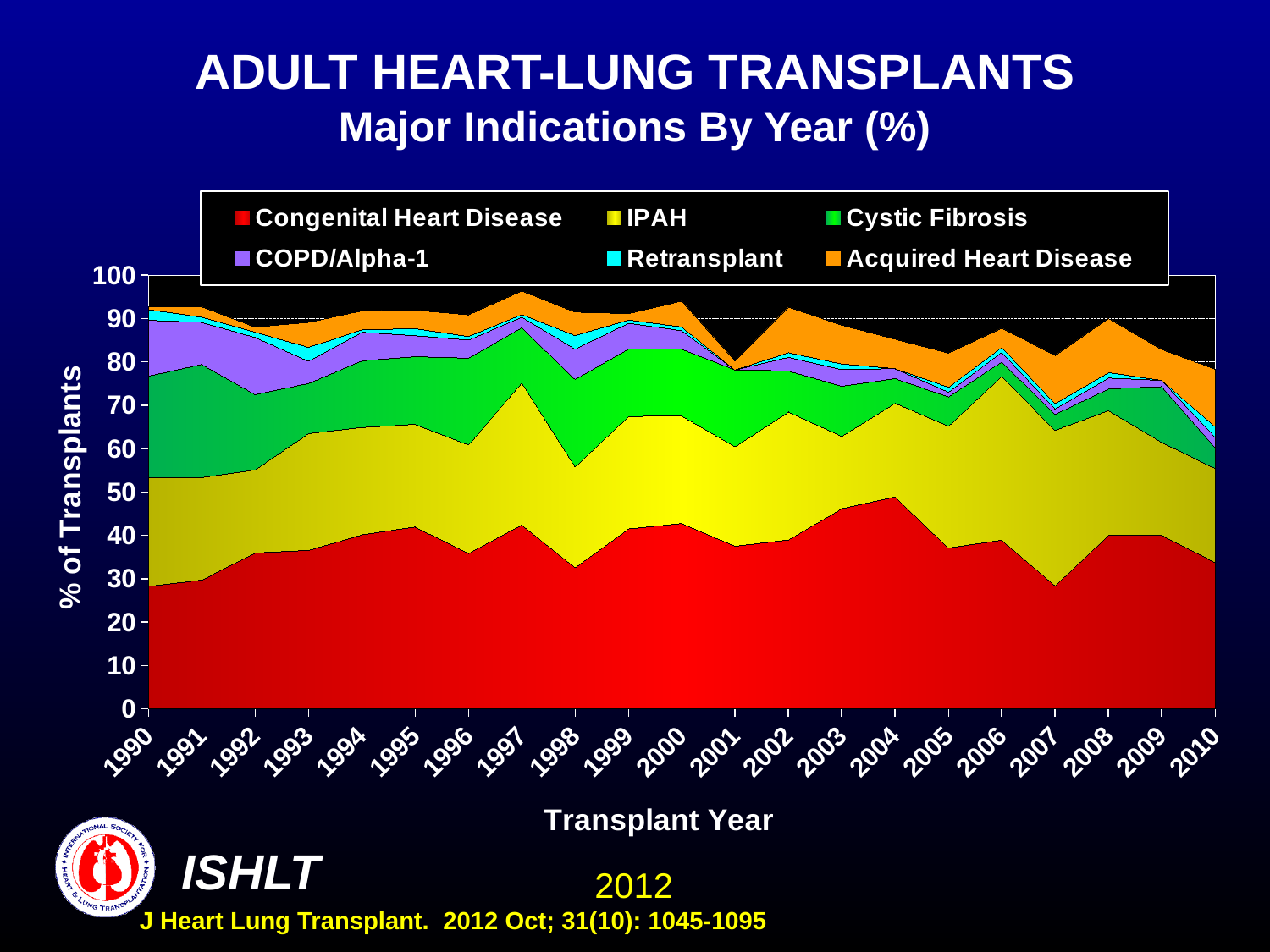
How many series does the legend list? 6 What colour represents Acquired Heart Disease in the legend? Orange Which indication has the largest share of transplants in 2010? Congenital Heart Disease Is the value for Congenital Heart Disease in 2004 greater or less than 40? greater Is the total height of the stacked areas in 2001 greater or less than 90? less What kind of chart is shown on the slide? Stacked area chart Is the value for Congenital Heart Disease in 2007 greater or less than 40? less How many transplant years are shown along the x axis? 21 Which is larger, the Congenital Heart Disease value in 2004 or in 2007? 2004 Does the Cystic Fibrosis band generally grow or shrink from 1990 to 2010? Shrink